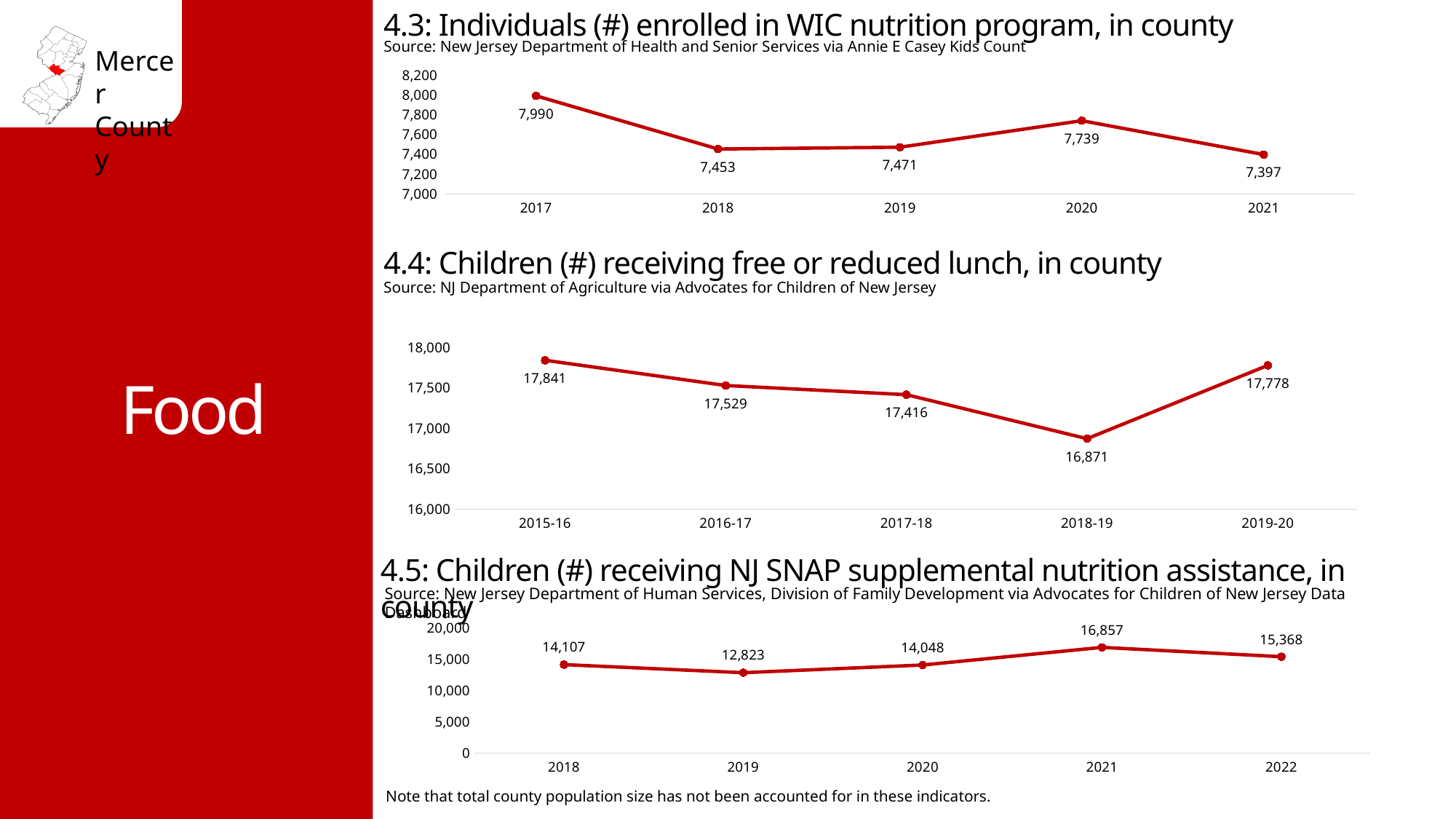
In the chart '4.5: Children (#) receiving NJ SNAP supplemental nutrition assistance, in county', which year has the lowest value? 2019 In the chart '4.4: Children (#) receiving free or reduced lunch, in county', which school year has the highest value? 2015-16 In the chart '4.4: Children (#) receiving free or reduced lunch, in county', is the value for 2019-20 larger than the value for 2017-18? Yes In the chart '4.5: Children (#) receiving NJ SNAP supplemental nutrition assistance, in county', what is the value for 2021? 16,857 In the chart '4.3: Individuals (#) enrolled in WIC nutrition program, in county', which year has the lowest value? 2021 In the chart '4.3: Individuals (#) enrolled in WIC nutrition program, in county', how many years are plotted? 5 In the chart '4.4: Children (#) receiving free or reduced lunch, in county', what is the value for 2018-19? 16,871 In the chart '4.4: Children (#) receiving free or reduced lunch, in county', what kind of chart is shown? Line chart In the chart '4.3: Individuals (#) enrolled in WIC nutrition program, in county', do the values rise or fall from 2017 to 2018? Fall In the chart '4.3: Individuals (#) enrolled in WIC nutrition program, in county', what is the value for 2017? 7,990 In the chart '4.5: Children (#) receiving NJ SNAP supplemental nutrition assistance, in county', what is the difference between the 2021 and 2022 values? 1,489 In the chart '4.3: Individuals (#) enrolled in WIC nutrition program, in county', what is the difference between the 2017 and 2018 values? 537